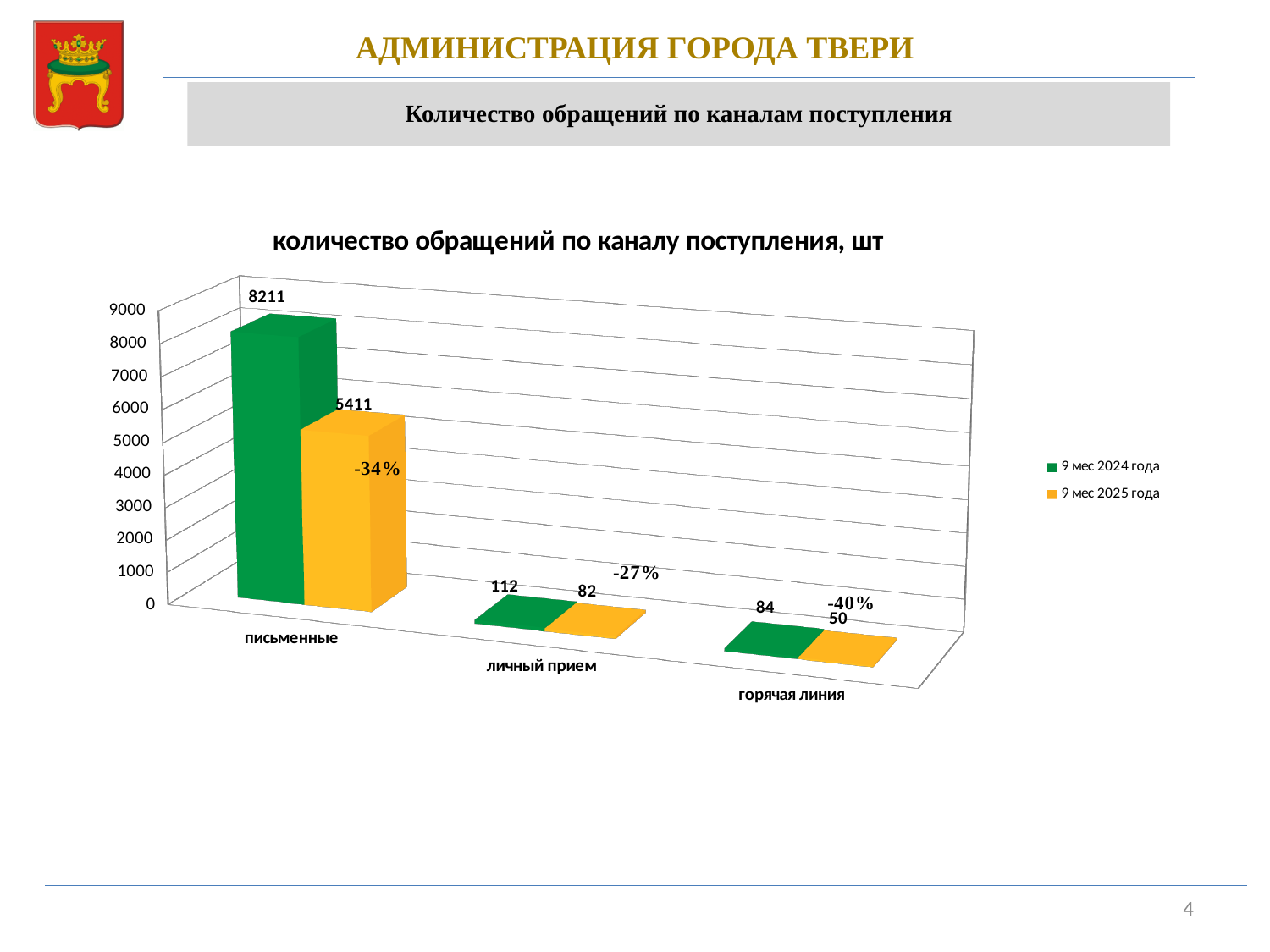
What is the difference between the 9 мес 2024 года and 9 мес 2025 года values for горячая линия? 34 What percentage change is labelled for личный прием? -27% How many categories are shown on the x axis? 3 What is the value for письменные in the 9 мес 2024 года series? 8211 What is the value for личный прием in the 9 мес 2024 года series? 112 Which category has the highest value in the 9 мес 2024 года series? письменные Which is larger for личный прием: the 9 мес 2024 года value or the 9 мес 2025 года value? 9 мес 2024 года What is the value for письменные in the 9 мес 2025 года series? 5411 How many series does the legend list? 2 Which category has the lowest value in the 9 мес 2025 года series? горячая линия What is the difference between the 9 мес 2024 года and 9 мес 2025 года values for письменные? 2800 What is the value for горячая линия in the 9 мес 2025 года series? 50